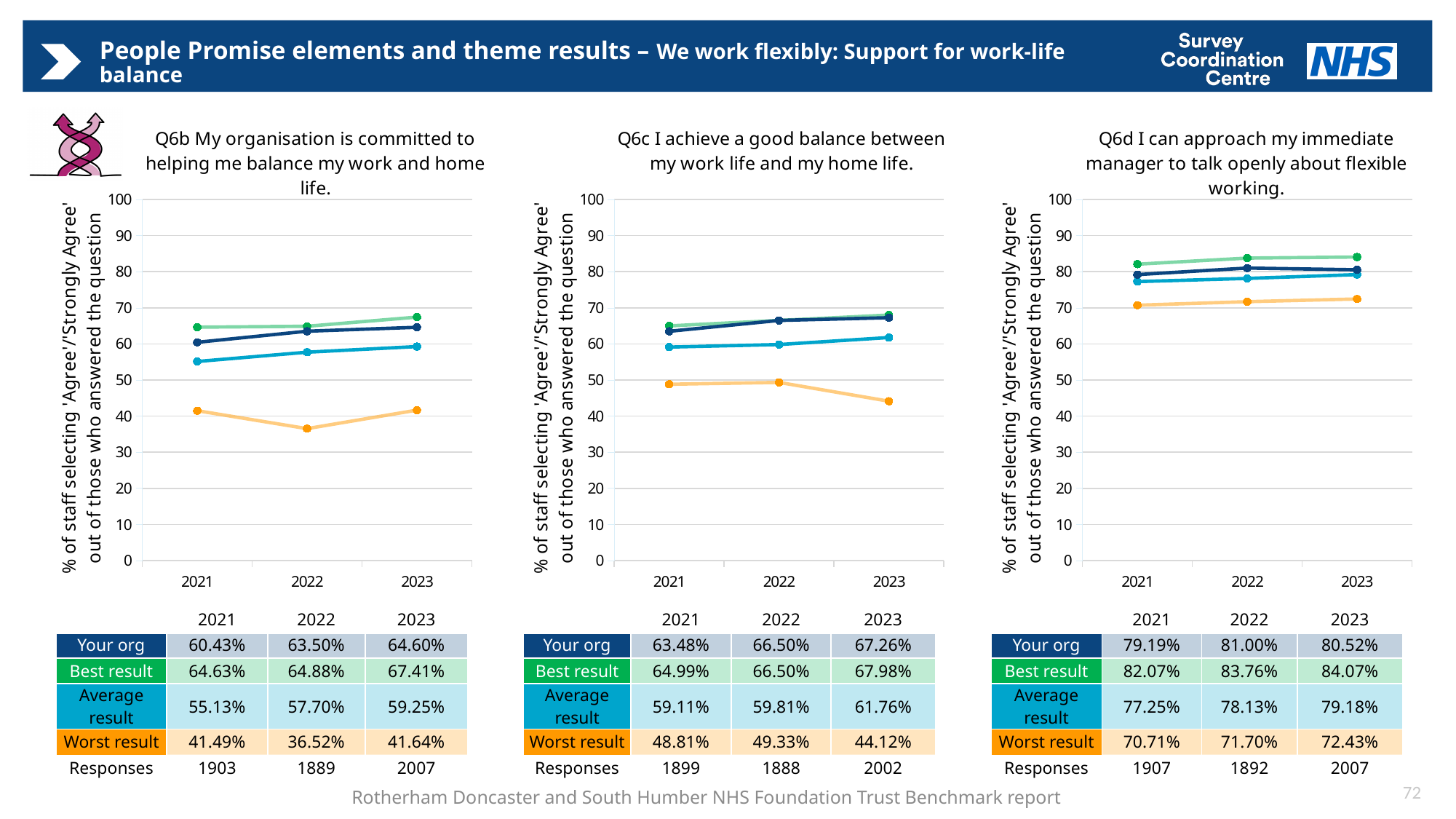
In the Q6c chart (I achieve a good balance between my work life and my home life), what is the 'Worst result' value for 2022? 49.33% In the Q6c chart, what is the difference between the 'Best result' and 'Your org' values for 2023? 0.72% In the Q6b chart, which year has the lowest 'Worst result' value? 2022 In the Q6d chart, does the 'Worst result' series rise or fall from 2021 to 2023? Rise In the Q6d chart (I can approach my immediate manager to talk openly about flexible working), what is the 'Best result' value for 2023? 84.07% How many series are shown in the Q6b chart? 4 What type of chart is used for Q6c? Line chart In the Q6c chart, is the 'Worst result' value for 2023 greater or less than 50? less In the Q6d chart, which year has the highest 'Your org' value? 2022 How many years are plotted on the x axis of the Q6d chart? 3 In the Q6b chart (My organisation is committed to helping me balance my work and home life), what is the 'Your org' value for 2023? 64.60% In the Q6b chart, which is larger for 2021: the 'Your org' value or the 'Average result' value? Your org